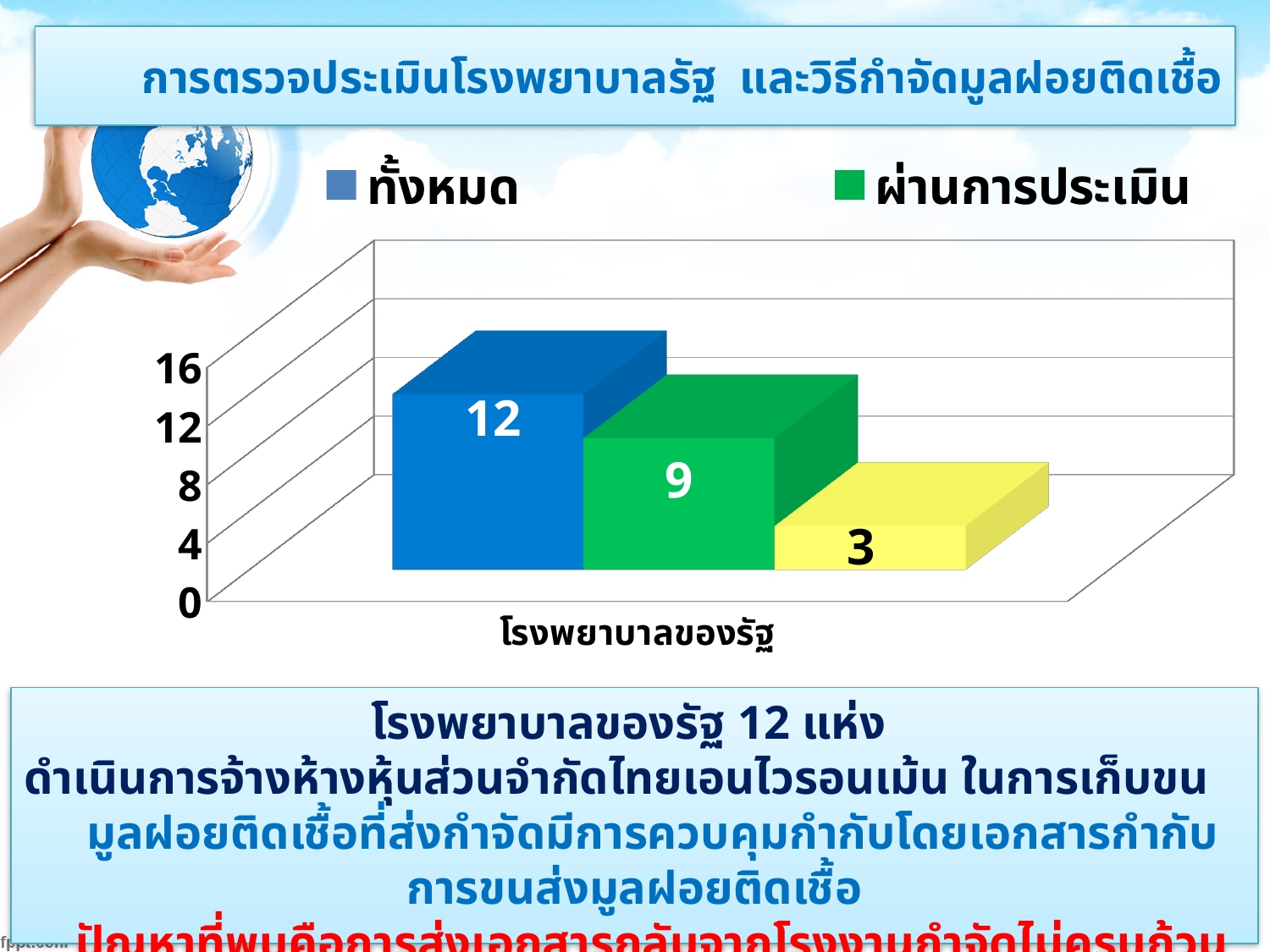
What value is printed on the yellow bar? 3 How many bars are plotted in the chart? 3 Which is larger, the ทั้งหมด bar or the ผ่านการประเมิน bar? ทั้งหมด What is the value of the lowest bar in the chart? 3 What is the category label shown on the x axis of the chart? โรงพยาบาลของรัฐ What kind of chart is shown on the slide? Bar chart Is the value for ผ่านการประเมิน greater or less than 4? greater Which series has the highest value in the chart? ทั้งหมด What is the value of the ทั้งหมด bar for โรงพยาบาลของรัฐ? 12 How many series does the legend list? 2 What is the value of the ผ่านการประเมิน bar for โรงพยาบาลของรัฐ? 9 What is the difference between the ทั้งหมด value and the ผ่านการประเมิน value? 3